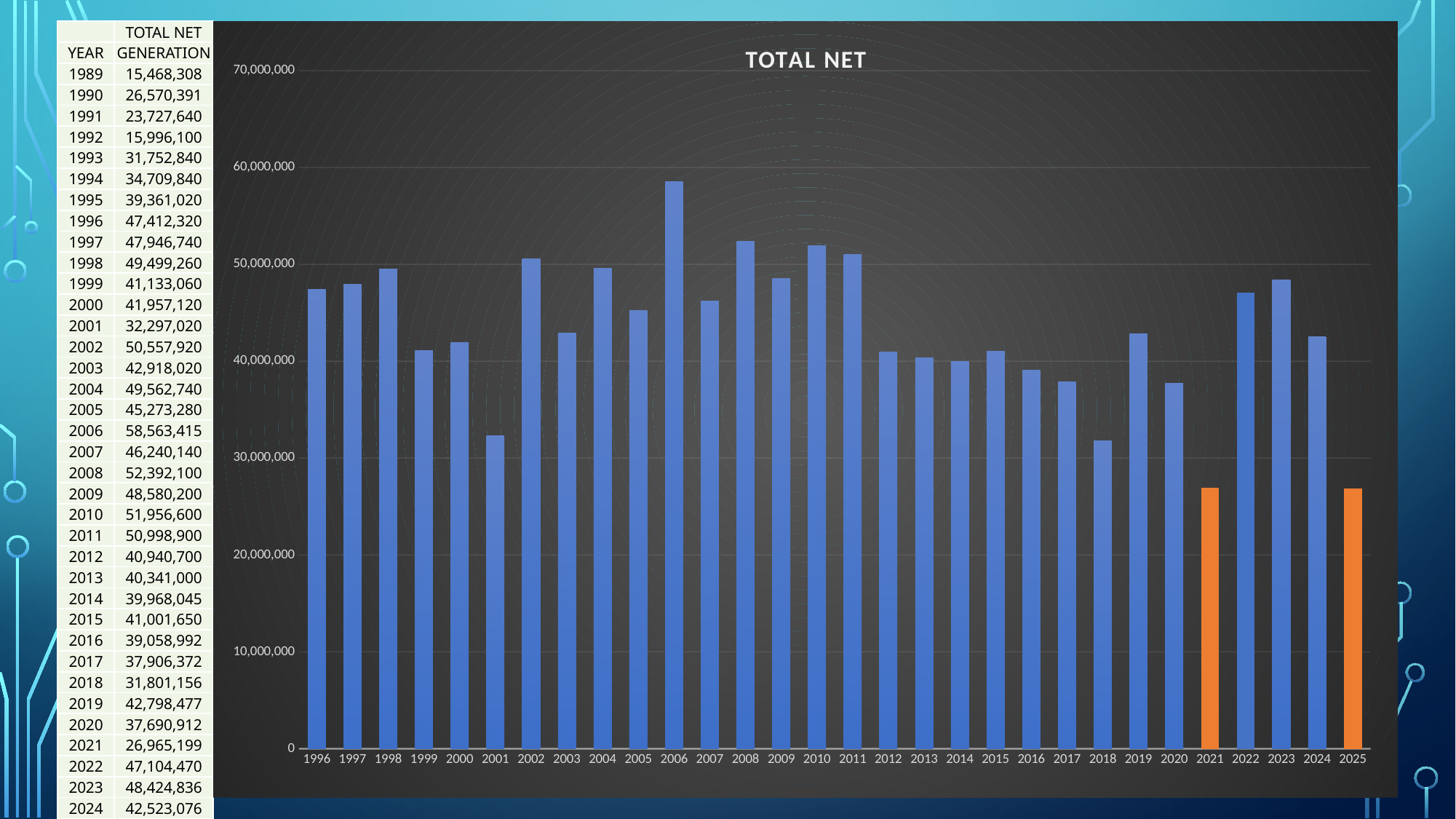
How many years are plotted as bars in the chart? 30 What is the total net generation for 2006? 58,563,415 Is the value for 2008 greater or less than 50,000,000? greater Is the value for 2025 greater or less than 30,000,000? less Which two years are shown with orange bars instead of blue? 2021 and 2025 What is the total net generation for 2021? 26,965,199 What is the title of the chart? TOTAL NET What is the difference between the total net generation for 2006 and for 2021? 31,598,216 Which year has the highest bar in the chart? 2006 Which is larger, the value for 2001 or the value for 2002? 2002 Do the values rise or fall from 2015 to 2018? fall What kind of chart is shown on the slide? bar chart